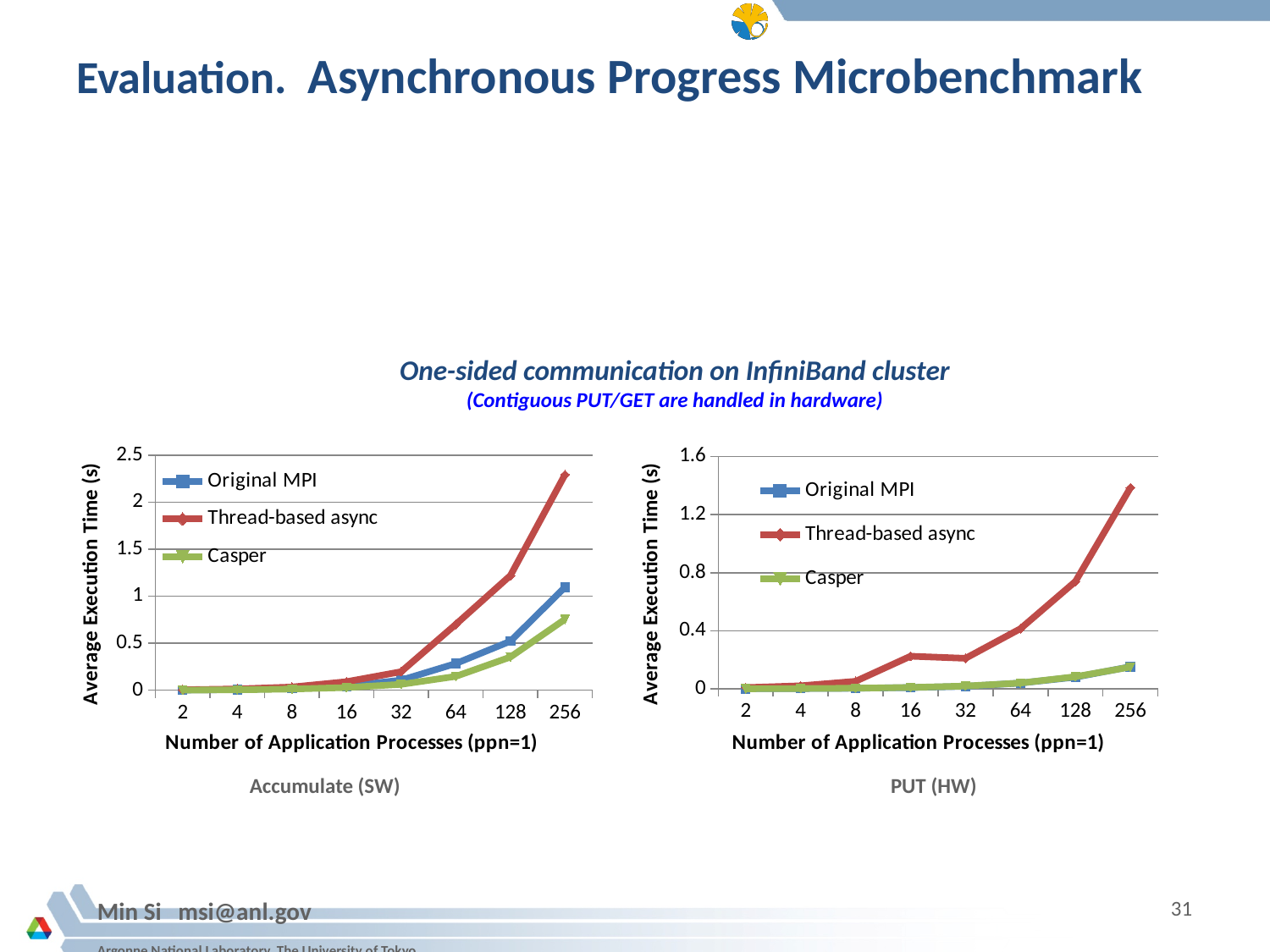
In the Accumulate (SW) chart, is the value for Thread-based async at 256 processes greater or less than 2? greater In the Accumulate (SW) chart, is the value for Original MPI at 256 processes greater or less than 1.5? less What type of chart is the Accumulate (SW) chart on the left? line chart In the Accumulate (SW) chart, which series has the lowest value at 256 processes? Casper In the PUT (HW) chart, which series has the highest value at 256 processes? Thread-based async In the PUT (HW) chart, is the value for Thread-based async at 16 processes greater or less than 0.4? less How many series does the legend of the PUT (HW) chart list? 3 How many x-axis categories (process counts) are plotted in the Accumulate (SW) chart? 8 In the Accumulate (SW) chart, which series has the highest value at 256 processes? Thread-based async In the PUT (HW) chart, does the Thread-based async series rise or fall as the number of processes increases from 64 to 256? rise